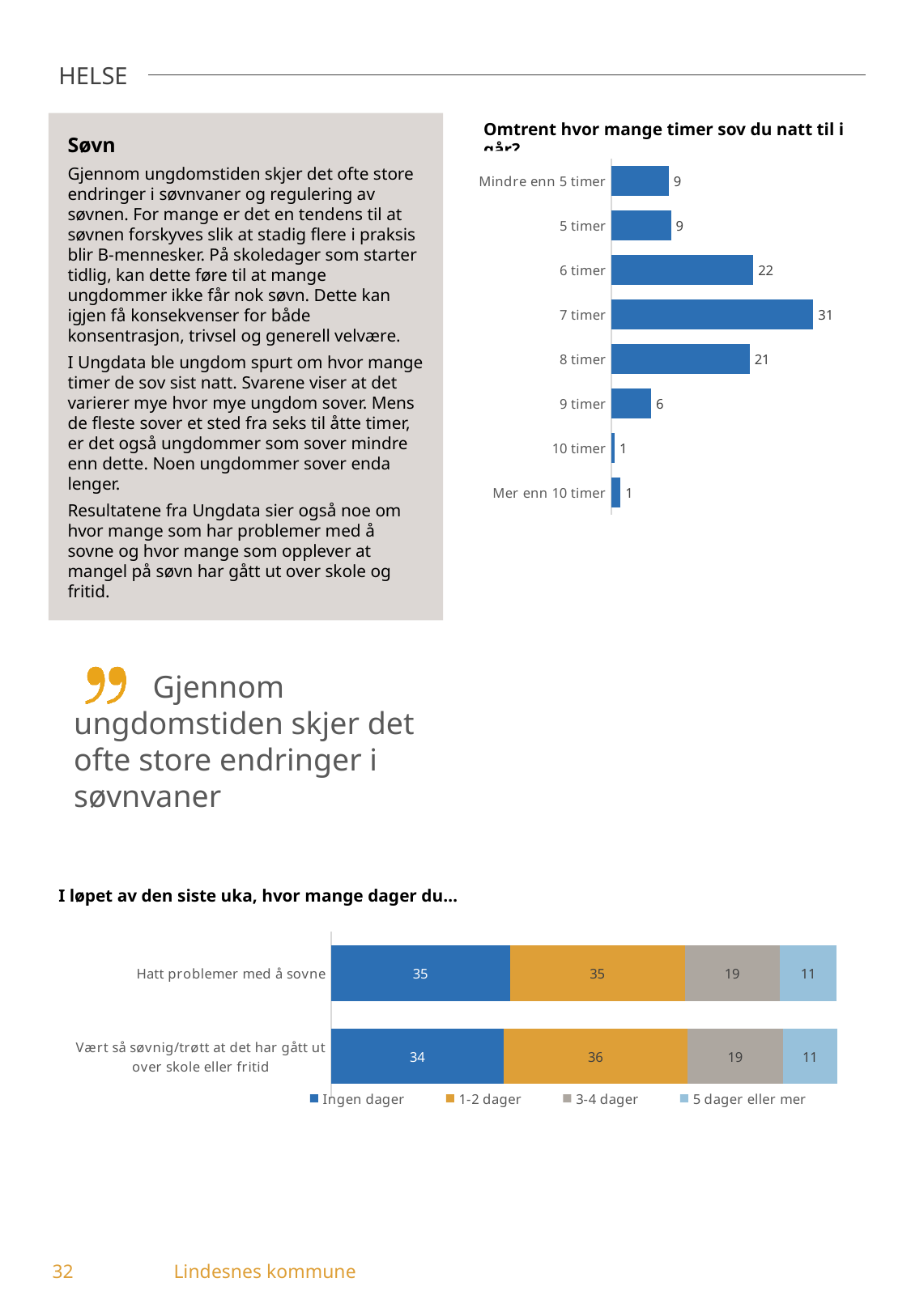
How many series does the legend list in the bottom chart "I løpet av den siste uka, hvor mange dager du…"? 4 In the top-right chart about hours slept last night, which category has the highest value? 7 timer What kind of chart is the top-right chart about hours slept last night? Bar chart In the top-right chart about hours slept last night, what is the value for "7 timer"? 31 In the top-right chart about hours slept last night, what is the value for "6 timer"? 22 In the bottom chart "I løpet av den siste uka, hvor mange dager du…", which legend entry is shown in orange? 1-2 dager How many categories are shown in the top-right chart about hours slept last night? 8 In the top-right chart about hours slept last night, which is larger, the value for "6 timer" or the value for "9 timer"? 6 timer In the bottom chart "I løpet av den siste uka, hvor mange dager du…", what is the value for "Ingen dager" in the row "Vært så søvnig/trøtt at det har gått ut over skole eller fritid"? 34 In the bottom chart "I løpet av den siste uka, hvor mange dager du…", what is the value for "1-2 dager" in the row "Hatt problemer med å sovne"? 35 In the bottom chart "I løpet av den siste uka, hvor mange dager du…", what is the total of the stacked bar for "Hatt problemer med å sovne"? 100 In the top-right chart about hours slept last night, what is the difference between the values for "7 timer" and "8 timer"? 10